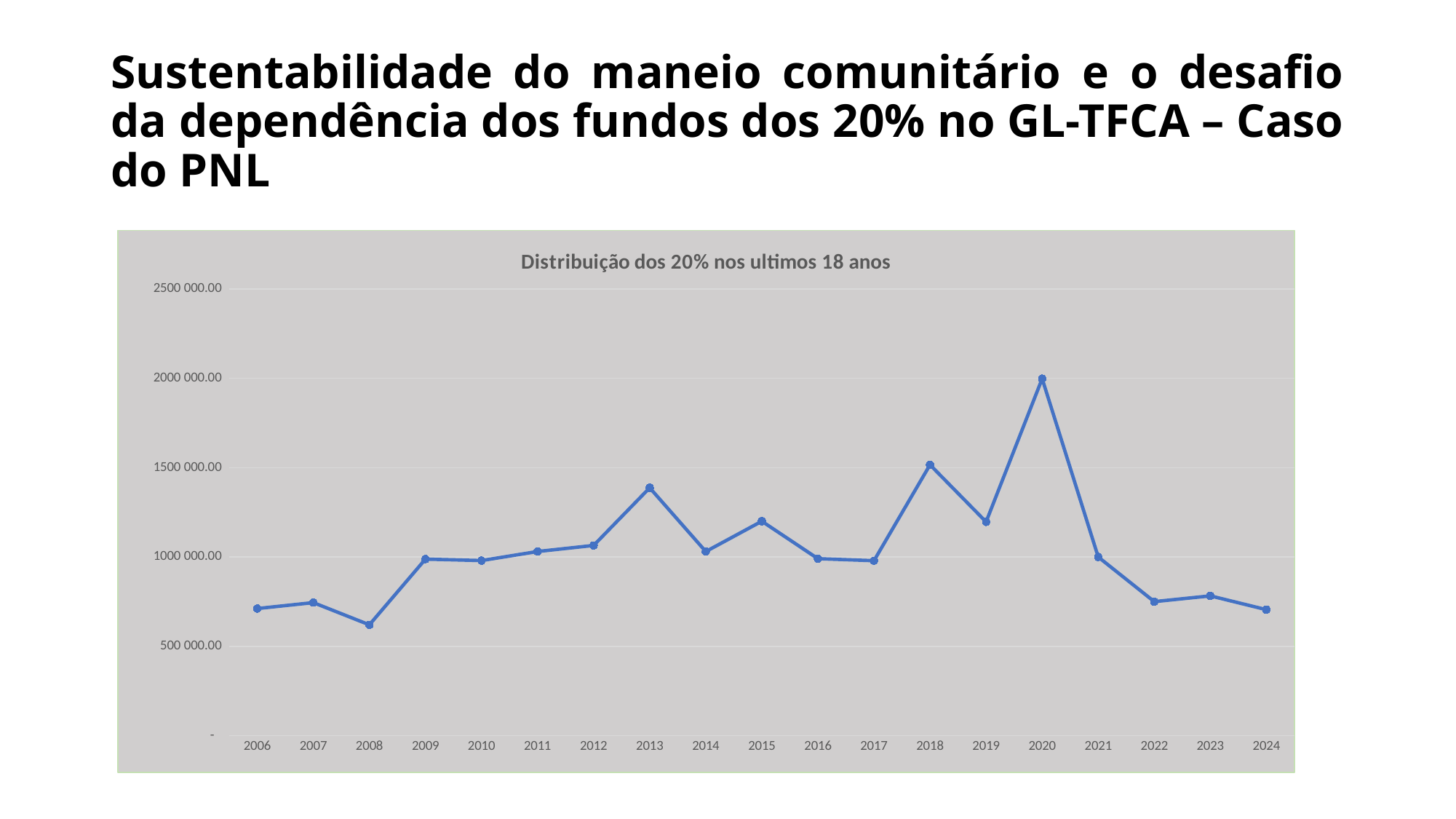
What is the title of the chart? Distribuição dos 20% nos ultimos 18 anos Is the value for 2013 greater or less than 1000 000.00? greater How many years are plotted on the x axis of the chart? 19 Is the value for 2020 greater or less than 1500 000.00? greater Which year has the highest value in the chart? 2020 Do the values rise or fall from 2020 to 2024? fall Is the value for 2008 greater or less than 1000 000.00? less Which year has the lowest value in the chart? 2008 Which year has the larger value, 2013 or 2014? 2013 Which year has the larger value, 2018 or 2020? 2020 What kind of chart is shown on the slide? line chart